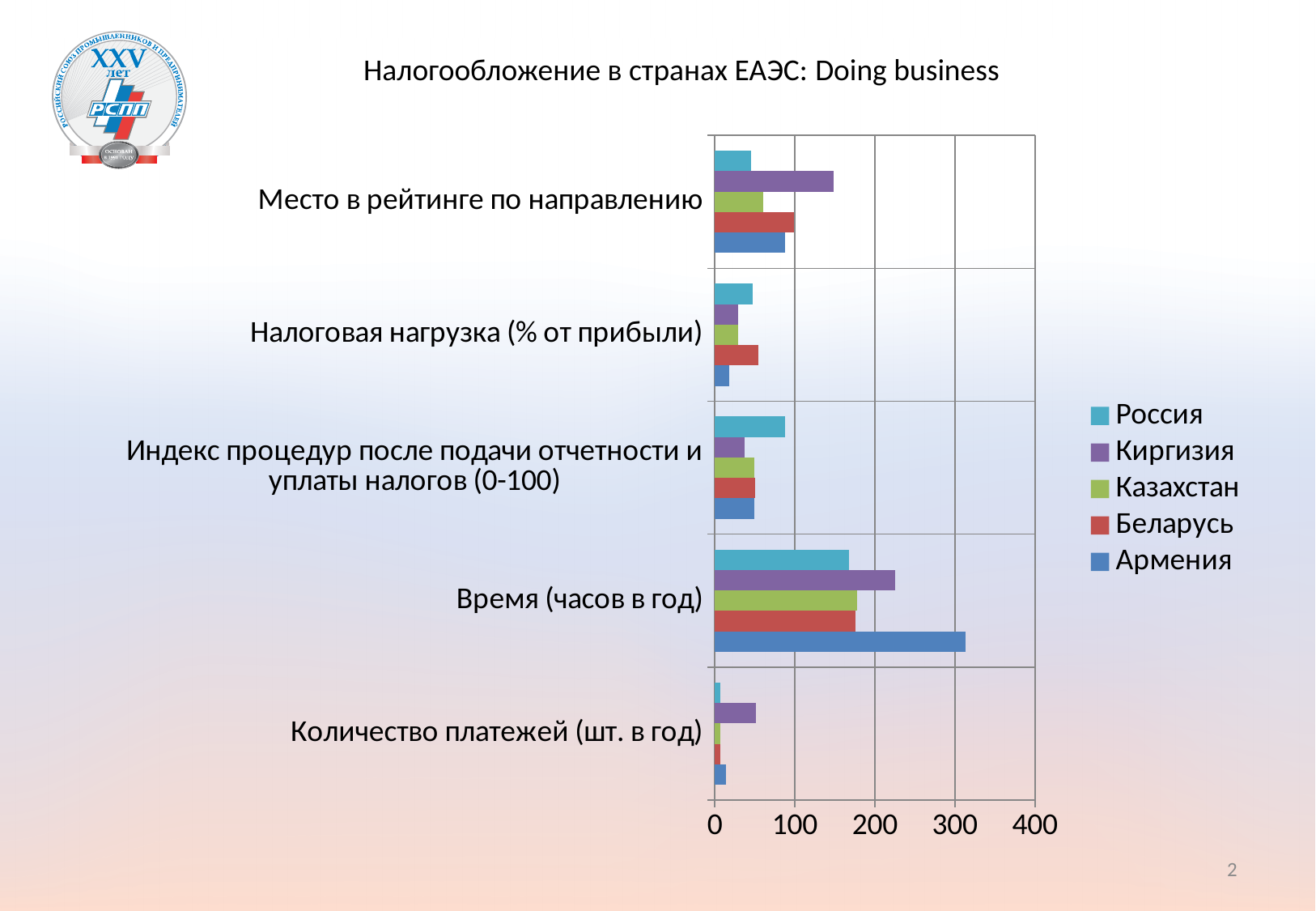
Which country has the highest value for Время (часов в год)? Армения Is the value for Киргизия in Место в рейтинге по направлению greater or less than 100? greater Which country has the highest value for Количество платежей (шт. в год)? Киргизия What is the title of the chart? Налогообложение в странах ЕАЭС: Doing business Is the value for Армения in Время (часов в год) greater or less than 300? greater Is the value for Киргизия in Время (часов в год) greater or less than 200? greater Which country has the highest value for Индекс процедур после подачи отчетности и уплаты налогов (0-100)? Россия How many series does the legend list? 5 In Налоговая нагрузка (% от прибыли), which is larger: the value for Россия or for Армения? Россия In Место в рейтинге по направлению, which is larger: the value for Киргизия or for Россия? Киргизия What kind of chart is shown on the slide? Bar chart How many categories are shown on the vertical axis of the chart? 5